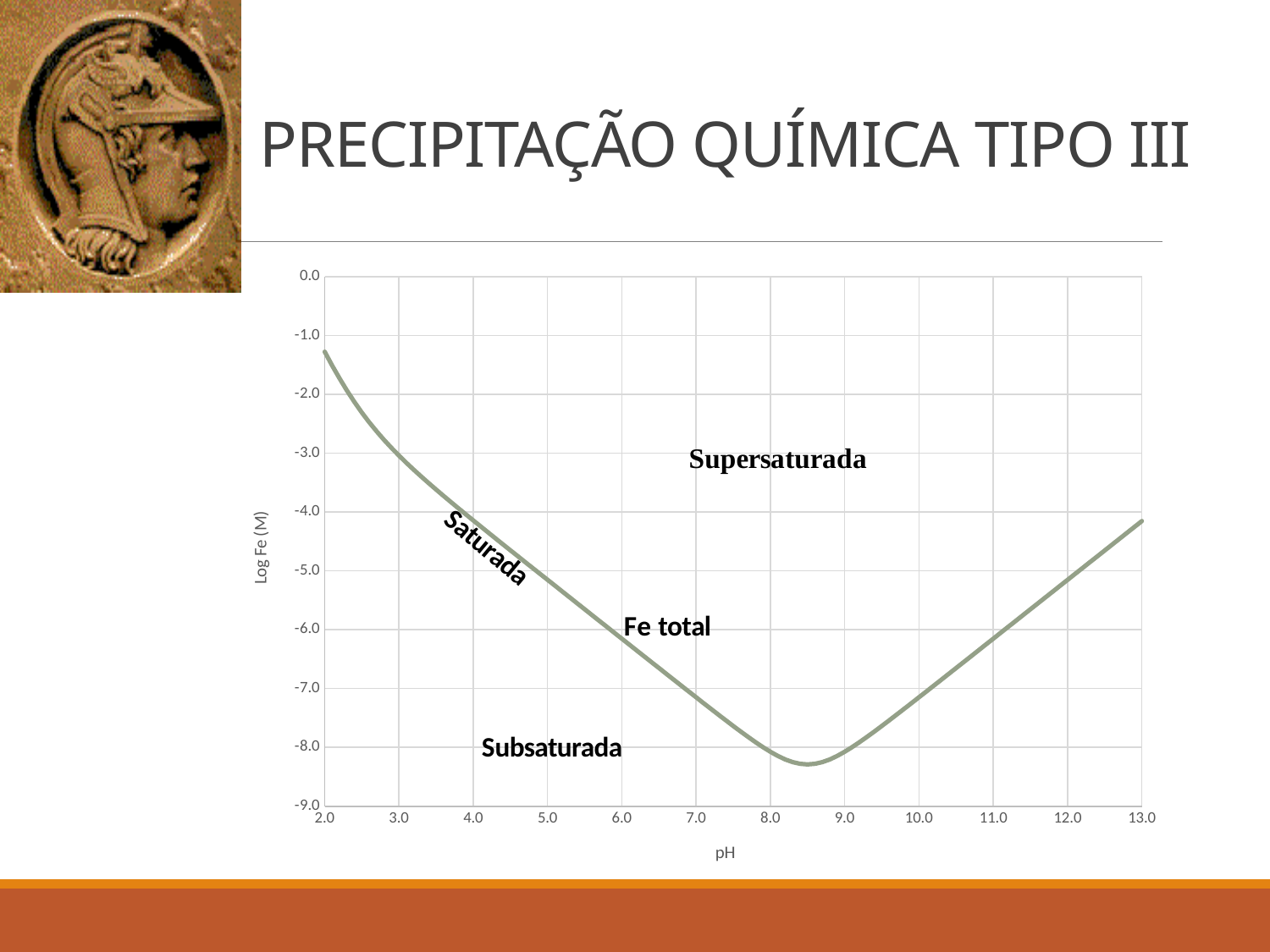
Does the Fe total curve rise or fall as pH increases from 2.0 to 8.0? fall Between which two x-axis ticks does the Fe total curve reach its minimum? 8.0 and 9.0 What is the label of the y axis? Log Fe (M) What kind of chart is shown on the slide? line chart Is the value of Log Fe (M) at pH 2.0 greater or less than -2.0? greater Which has the higher Log Fe (M) value on the curve: pH 2.0 or pH 13.0? pH 2.0 Is the value of Log Fe (M) at pH 13.0 greater or less than -5.0? greater Does the Fe total curve rise or fall as pH increases from 9.0 to 13.0? rise Is the lowest value of the Fe total curve greater or less than -8.0? less Which has the higher Log Fe (M) value on the curve: pH 3.0 or pH 8.0? pH 3.0 What is the highest pH value shown on the x axis? 13.0 What is the label of the x axis? pH